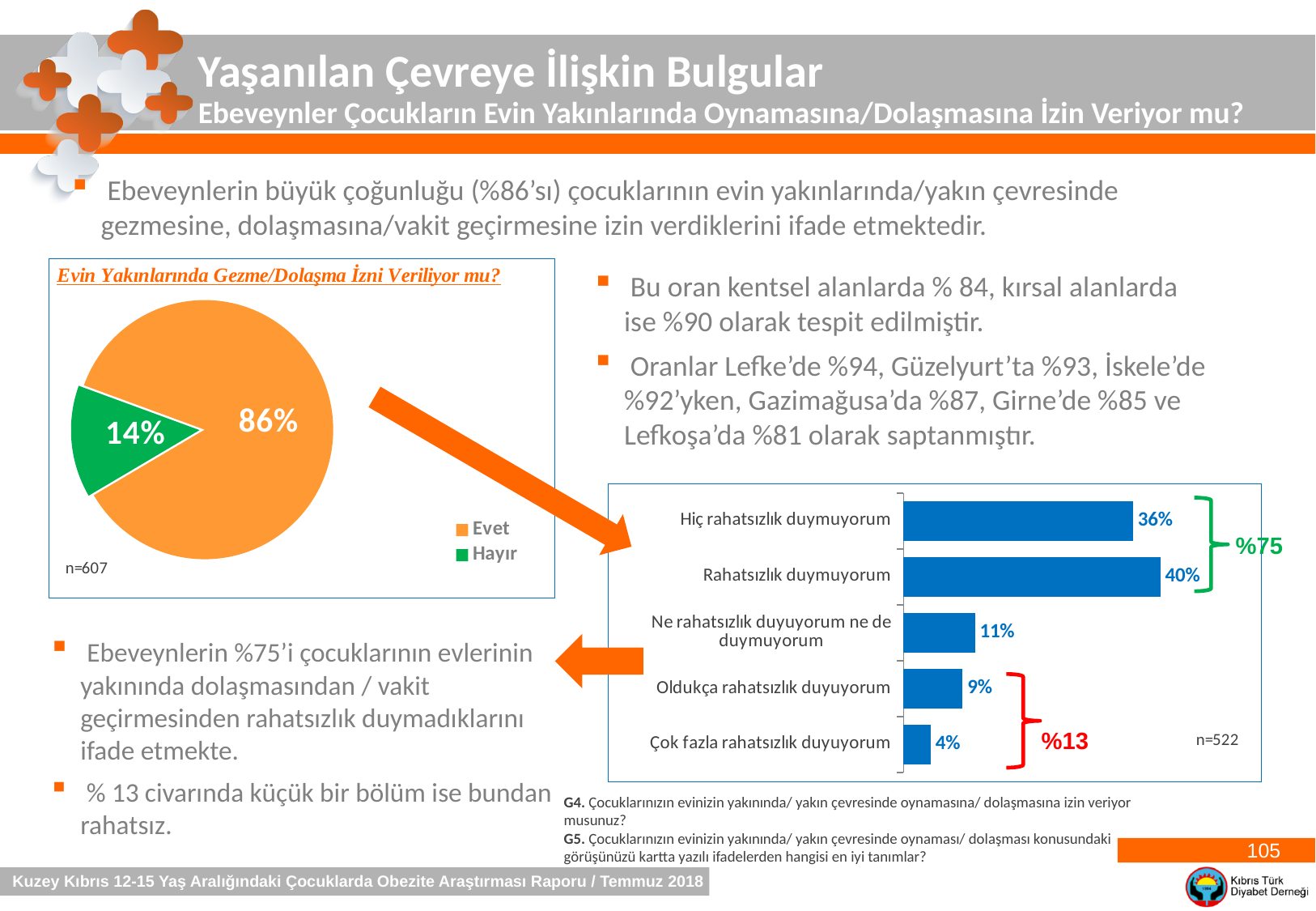
What type of chart is the chart on the left of the slide? Pie chart In the bar chart on the lower right, which category has the highest value? Rahatsızlık duymuyorum In the bar chart on the lower right, which category has the lowest value? Çok fazla rahatsızlık duyuyorum How many categories does the bar chart on the lower right show? 5 In the pie chart on the left, which slice is larger, "Evet" or "Hayır"? Evet How many entries does the legend of the pie chart on the left list? 2 In the pie chart titled "Evin Yakınlarında Gezme/Dolaşma İzni Veriliyor mu?", what share is labelled "Evet"? 86% In the pie chart on the left, what is the difference between the "Evet" and "Hayır" shares? 72% In the bar chart on the lower right, what is the value for "Çok fazla rahatsızlık duyuyorum"? 4% In the pie chart titled "Evin Yakınlarında Gezme/Dolaşma İzni Veriliyor mu?", what share is labelled "Hayır"? 14% In the bar chart on the lower right, what is the value for "Rahatsızlık duymuyorum"? 40% What type of chart is the chart on the lower right of the slide? Bar chart